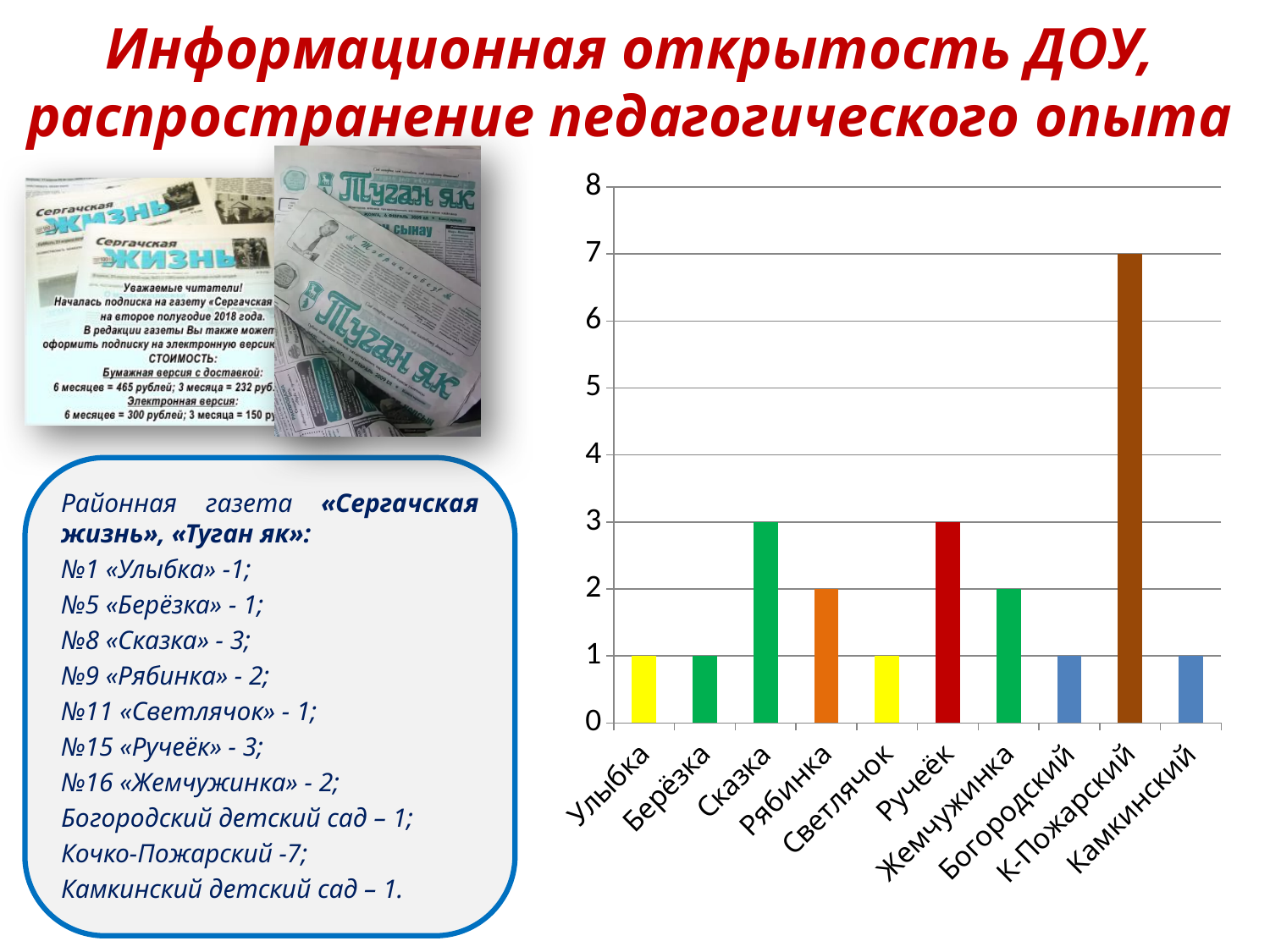
What is the value for Рябинка? 2 What is the maximum value shown on the vertical axis? 8 What kind of chart is shown on the slide? bar chart What is the difference between the values for К-Пожарский and Ручеёк? 4 How many categories have a value of 1? 5 What is the value for Сказка? 3 What is the value for К-Пожарский? 7 Which category has the highest value? К-Пожарский Which is larger, the value for Жемчужинка or the value for Светлячок? Жемчужинка How many categories are shown on the x axis? 10 What is the value for Богородский? 1 Is the value for К-Пожарский greater or less than 5? greater